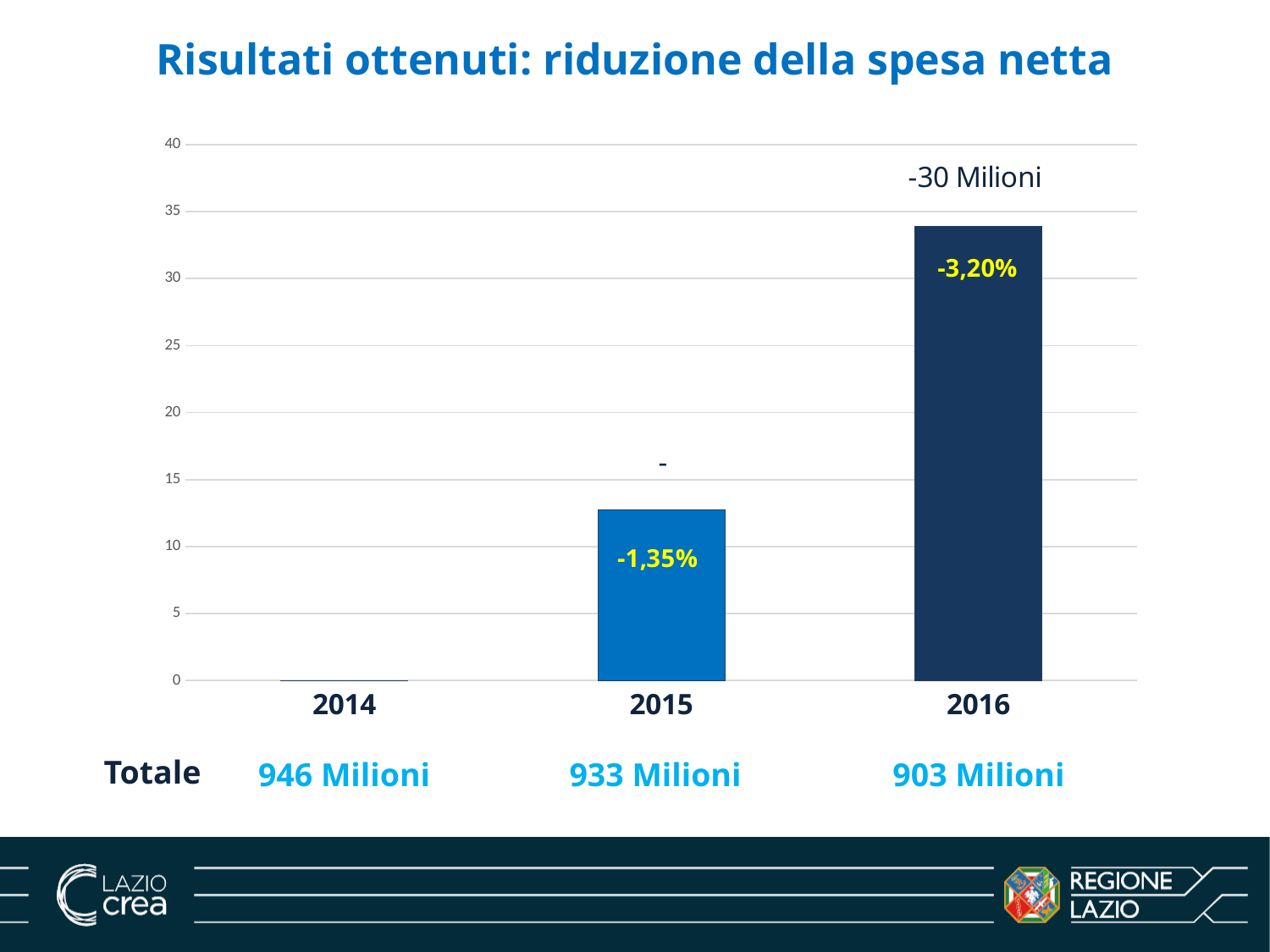
Which year has the tallest bar in the chart? 2016 Is the bar for 2016 greater or less than 30 on the y axis? greater What is the difference between the Totale for 2015 and the Totale for 2016? 30 Milioni What amount in Milioni is written above the bar for 2016? -30 Milioni How many years are shown on the x axis of the chart? 3 What is the Totale shown for 2014? 946 Milioni What percentage label is shown on the bar for 2015? -1,35% What is the Totale shown for 2016? 903 Milioni What percentage label is shown on the bar for 2016? -3,20% Which year has the lowest bar in the chart? 2014 What is the title of the chart? Risultati ottenuti: riduzione della spesa netta What type of chart is shown on the slide? bar chart